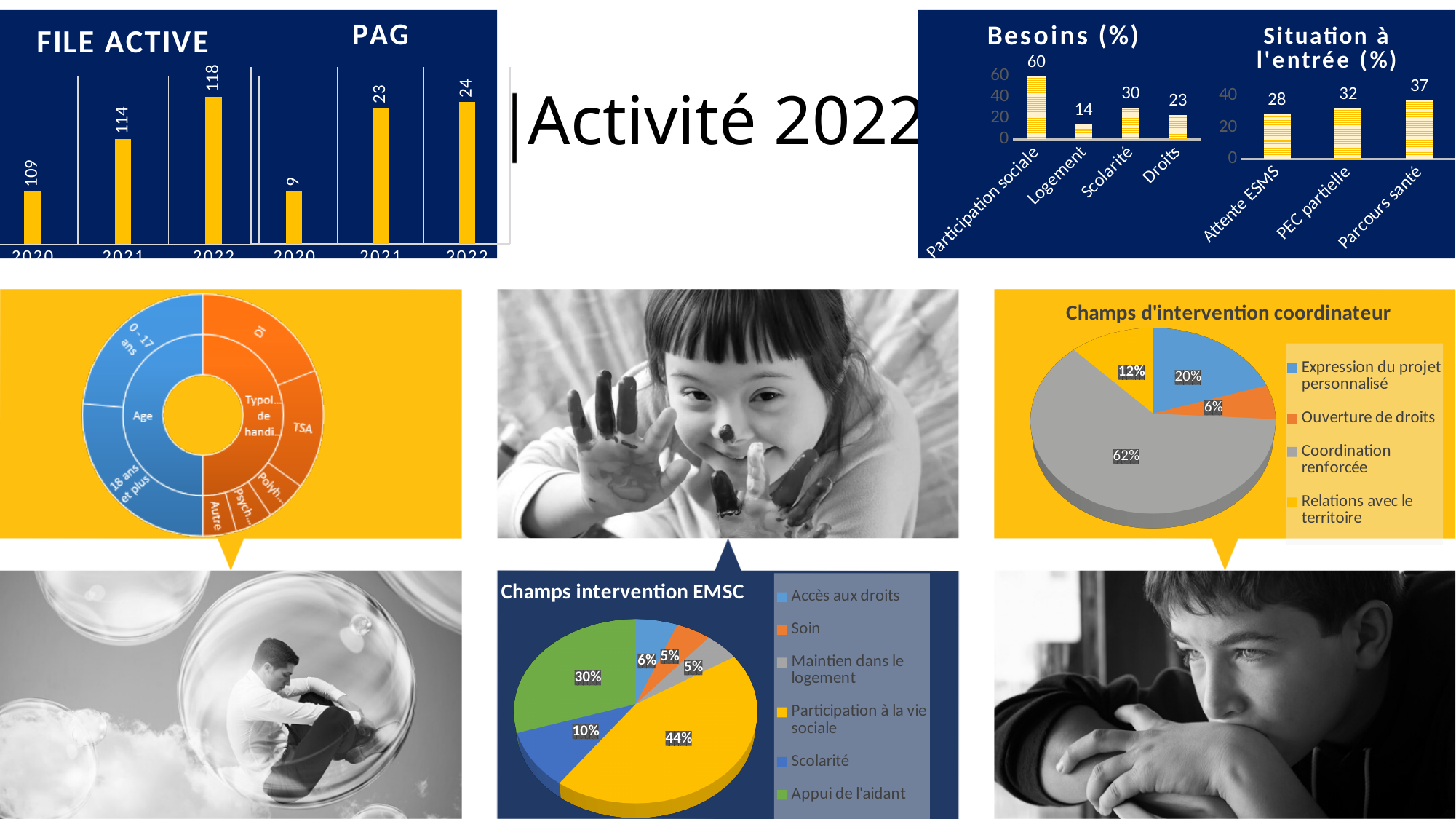
In the Situation à l'entrée (%) chart, how many categories are shown? 3 In the Besoins (%) chart, which category has the lowest value? Logement In the Champs intervention EMSC chart, what share does Appui de l'aidant have? 30% In the FILE ACTIVE chart, do the values rise or fall from 2020 to 2022? rise In the FILE ACTIVE chart, what is the value for 2022? 118 In the PAG chart, what is the difference between the 2021 and 2020 values? 14 In the PAG chart, what is the value for 2020? 9 In the Champs intervention EMSC chart, how many entries does the legend list? 6 In the Besoins (%) chart, which category has the highest value? Participation sociale In the Besoins (%) chart, what is the value for Scolarité? 30 In the Champs d'intervention coordinateur chart, what share does Coordination renforcée have? 62% In the Situation à l'entrée (%) chart, what is the value for Parcours santé? 37